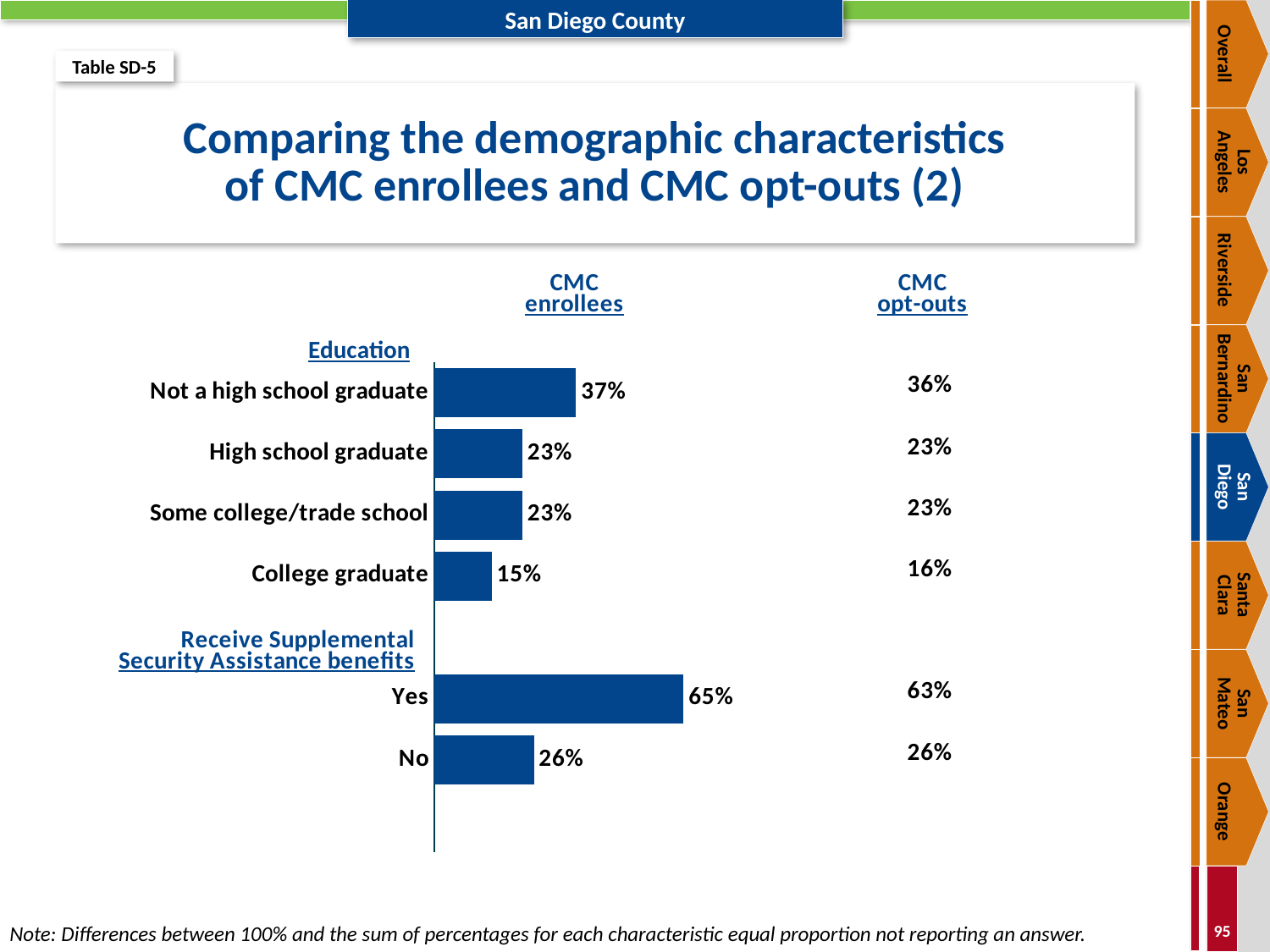
What is the title of the chart on the slide? Comparing the demographic characteristics of CMC enrollees and CMC opt-outs (2) What is the difference between the CMC enrollees percentage for Yes and No on receiving Supplemental Security Assistance benefits? 39% What percentage of CMC enrollees are not a high school graduate? 37% What is the difference between CMC enrollees and CMC opt-outs for Not a high school graduate? 1% What percentage of CMC opt-outs answered No to receiving Supplemental Security Assistance benefits? 26% How many education categories are shown in the chart? 4 Which is larger for CMC enrollees: Not a high school graduate or College graduate? Not a high school graduate Which education category has the lowest percentage among CMC enrollees? College graduate What percentage of CMC enrollees receive Supplemental Security Assistance benefits (Yes)? 65% What percentage of CMC opt-outs are college graduates? 16% Which education category has the highest percentage among CMC enrollees? Not a high school graduate What type of chart is used to show the CMC enrollees values? Bar chart